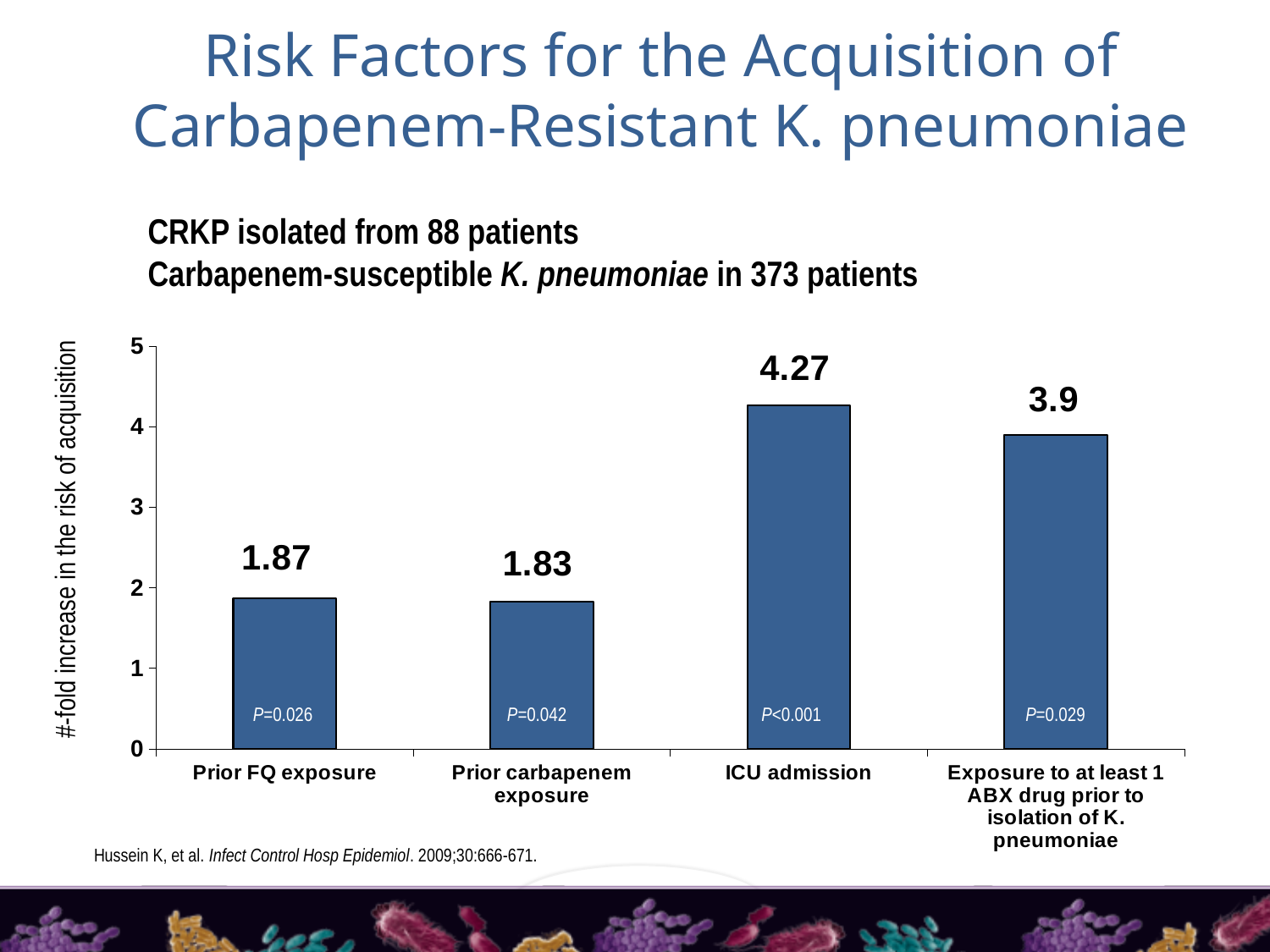
What is the #-fold increase in the risk of acquisition for Exposure to at least 1 ABX drug prior to isolation of K. pneumoniae? 3.9 Which has a larger #-fold increase in the risk of acquisition: ICU admission or Prior FQ exposure? ICU admission How many risk factors are shown on the chart? 4 Which risk factor has the highest #-fold increase in the risk of acquisition? ICU admission What is the #-fold increase in the risk of acquisition for Prior FQ exposure? 1.87 Which risk factor has the lowest #-fold increase in the risk of acquisition? Prior carbapenem exposure What is the difference between the #-fold increase for ICU admission and for Exposure to at least 1 ABX drug prior to isolation of K. pneumoniae? 0.37 What is the #-fold increase in the risk of acquisition for ICU admission? 4.27 What is the #-fold increase in the risk of acquisition for Prior carbapenem exposure? 1.83 What kind of chart is shown on the slide? Bar chart What is the difference between the #-fold increase for ICU admission and for Prior FQ exposure? 2.4 What P value is printed on the bar for ICU admission? P<0.001